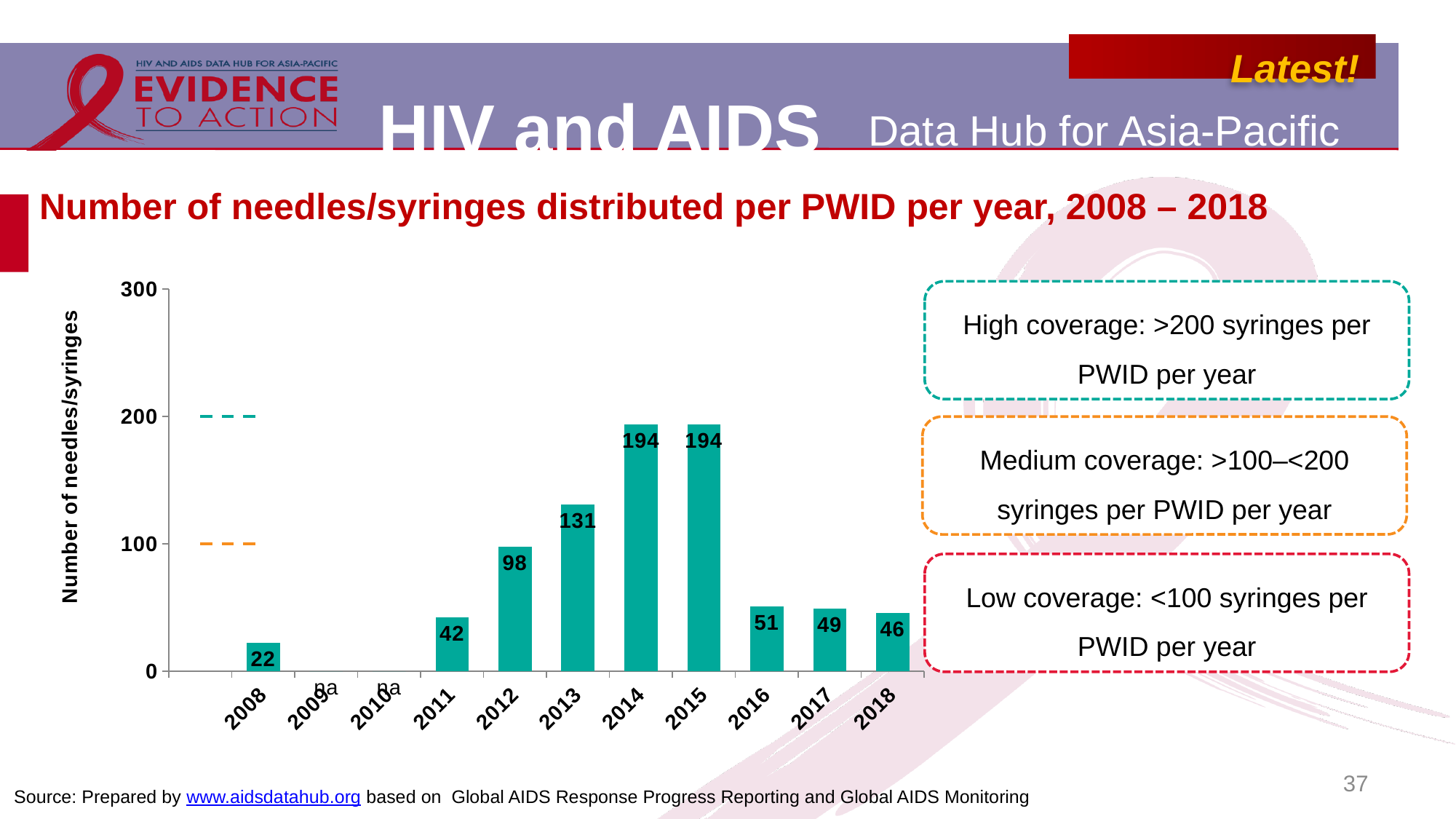
Which year has the larger value, 2012 or 2016? 2012 What is the difference between the values for 2013 and 2012? 33 Do the values rise or fall from 2015 to 2018? fall Is the value for 2016 greater or less than 100? less What is the number of needles/syringes distributed per PWID in 2013? 131 What kind of chart is shown on the slide? bar chart What value is shown for 2017? 49 What is the highest value plotted on the chart? 194 How many years are labelled 'na' instead of having a bar? 2 Which year has the lowest plotted value? 2008 What is the difference between the values for 2014 and 2016? 143 What value is shown for 2008? 22